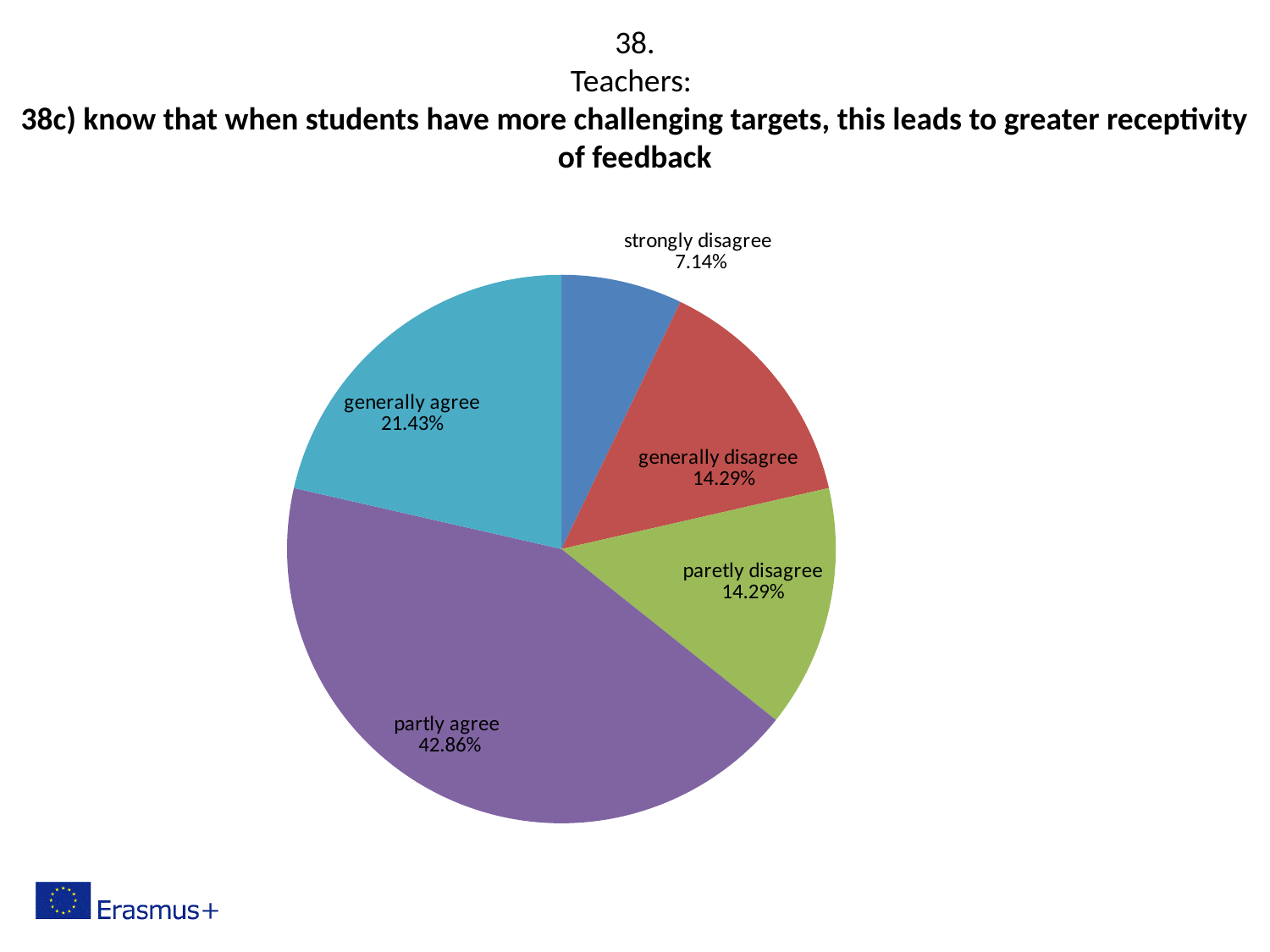
Which category has the smallest slice of the pie? strongly disagree What share of the pie is labelled "generally disagree"? 14.29% What colour is the "partly agree" slice? purple What share of the pie is labelled "partly agree"? 42.86% What kind of chart is shown on the slide? pie chart What share of the pie is labelled "strongly disagree"? 7.14% How many slices does the pie chart have? 5 What is the difference between the shares for "generally disagree" and "strongly disagree"? 7.15% Which is larger, the share for "generally agree" or the share for "paretly disagree"? generally agree Which category has the largest slice of the pie? partly agree What is the difference between the shares for "partly agree" and "generally agree"? 21.43%